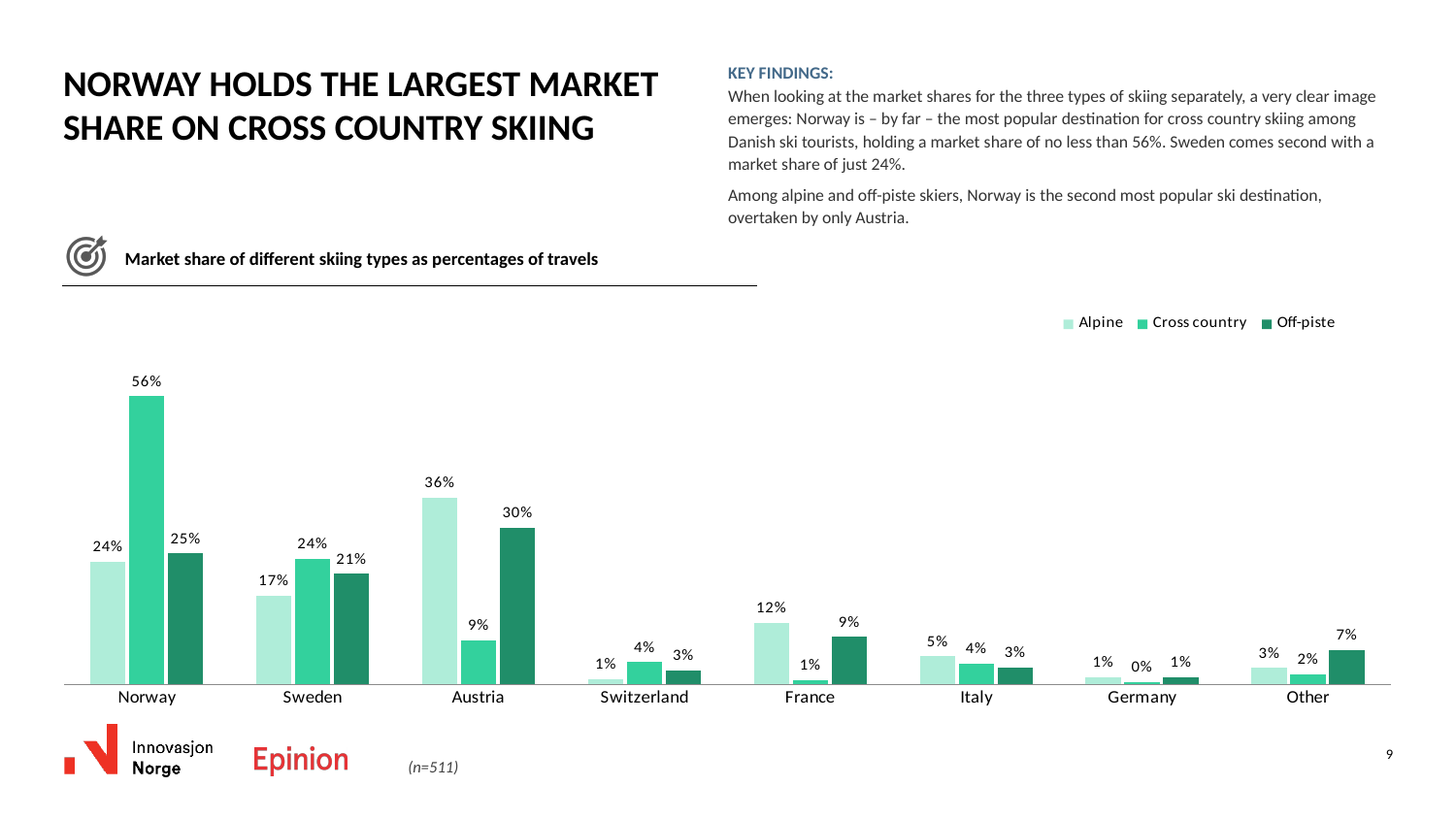
Which country has the highest Alpine market share? Austria How many countries/categories are shown on the x axis? 8 Which category has the lowest Cross country market share? Germany What is the difference between Norway's and Sweden's Cross country market shares? 32 percentage points What is the sample size noted below the chart? n=511 Which country has the highest Cross country market share? Norway What is the Off-piste market share for Sweden? 21% What is the Alpine market share for Austria? 36% Which is larger: the Off-piste share for Austria or the Off-piste share for Norway? Austria What kind of chart is shown on the slide? Bar chart What is the Cross country market share for Norway? 56% How many series does the legend list? 3